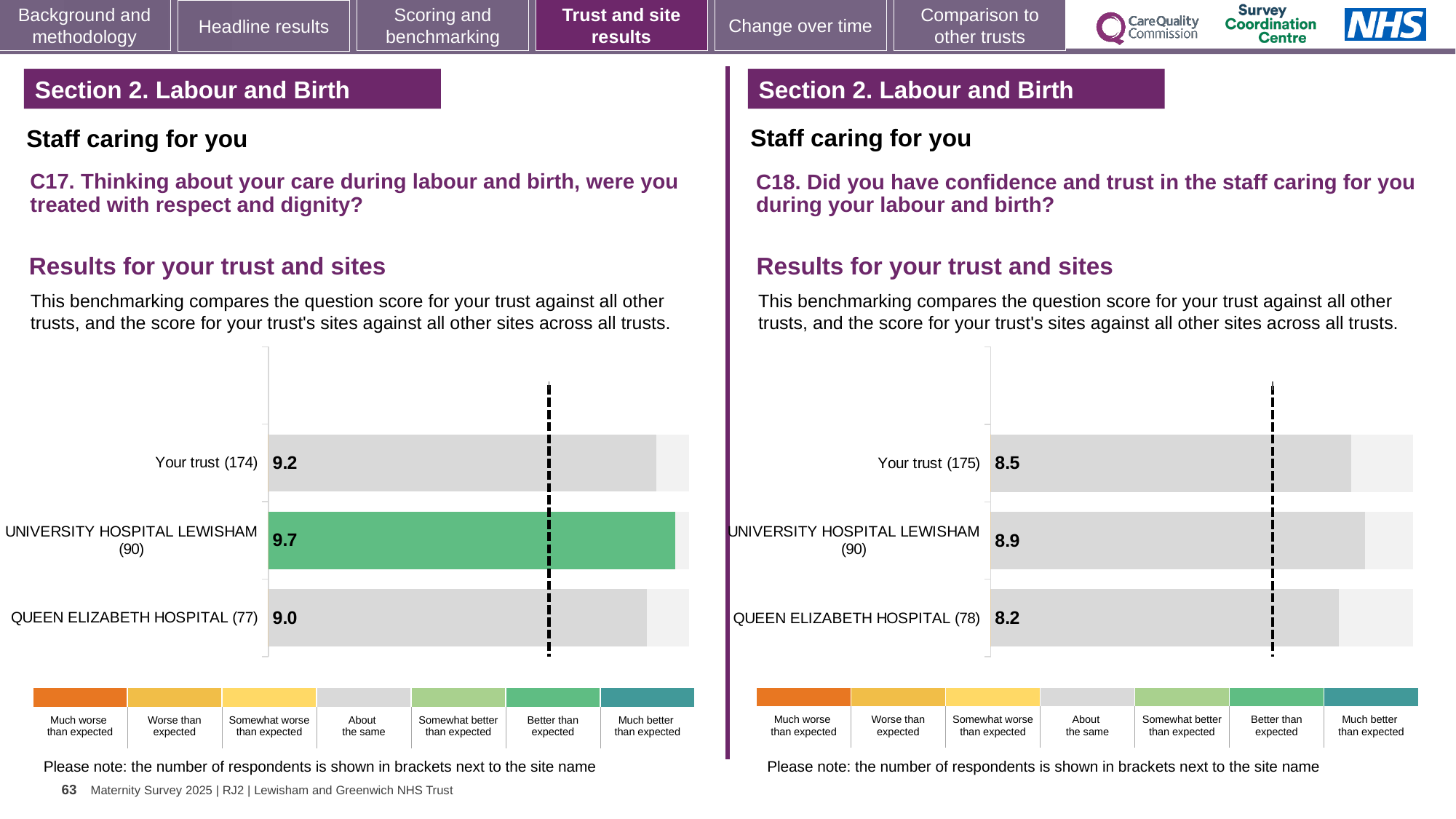
In the C18 chart on the right, which site or trust has the highest score? University Hospital Lewisham In the C17 chart on the left, what is the difference between the scores for University Hospital Lewisham and Queen Elizabeth Hospital? 0.7 In the C17 chart on the left, what is the score for Queen Elizabeth Hospital? 9.0 In the C18 chart on the right, what is the score for Queen Elizabeth Hospital? 8.2 In the C17 chart on the left, what is the score for University Hospital Lewisham? 9.7 What type of chart is used for the C18 results on the right? Bar chart In the C18 chart on the right, what is the difference between the scores for University Hospital Lewisham and Your trust? 0.4 In the C18 chart on the right, which has the larger score, Your trust or Queen Elizabeth Hospital? Your trust In the C17 chart on the left, which site or trust has the lowest score? Queen Elizabeth Hospital In the C17 chart on the left, what is the score for Your trust? 9.2 How many bars are plotted in the C17 chart on the left? 3 In the C18 chart on the right, what is the score for Your trust? 8.5